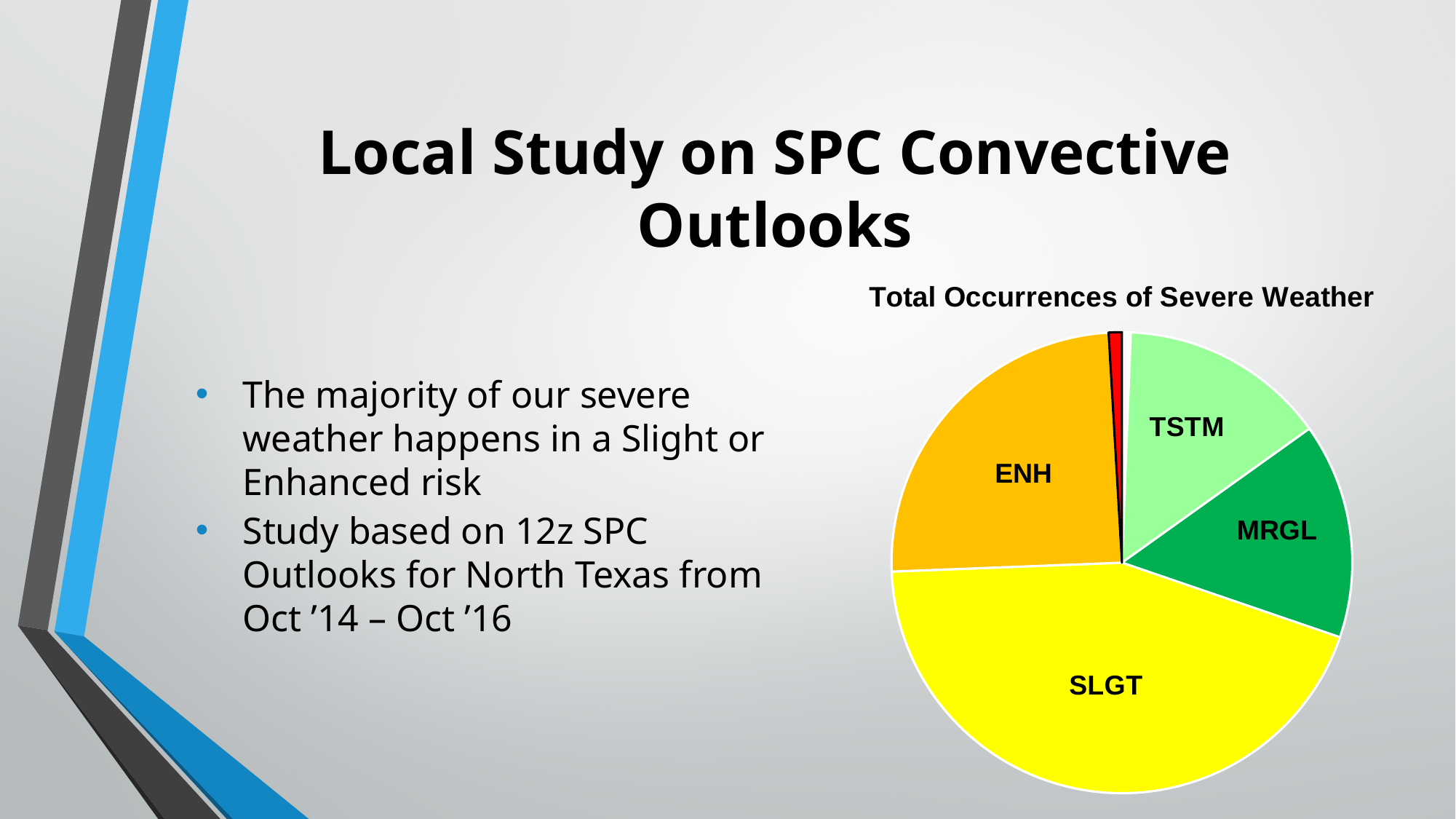
What colour is the SLGT slice? yellow Which slice is larger, SLGT or ENH? SLGT What is the title of the chart? Total Occurrences of Severe Weather Which slice is larger, ENH or MRGL? ENH How many slices does the pie chart have? 6 Which slice is larger, SLGT or MRGL? SLGT What kind of chart is shown on the slide? pie chart Which category has the largest slice of the pie? SLGT How many slices in the pie chart have a readable label? 4